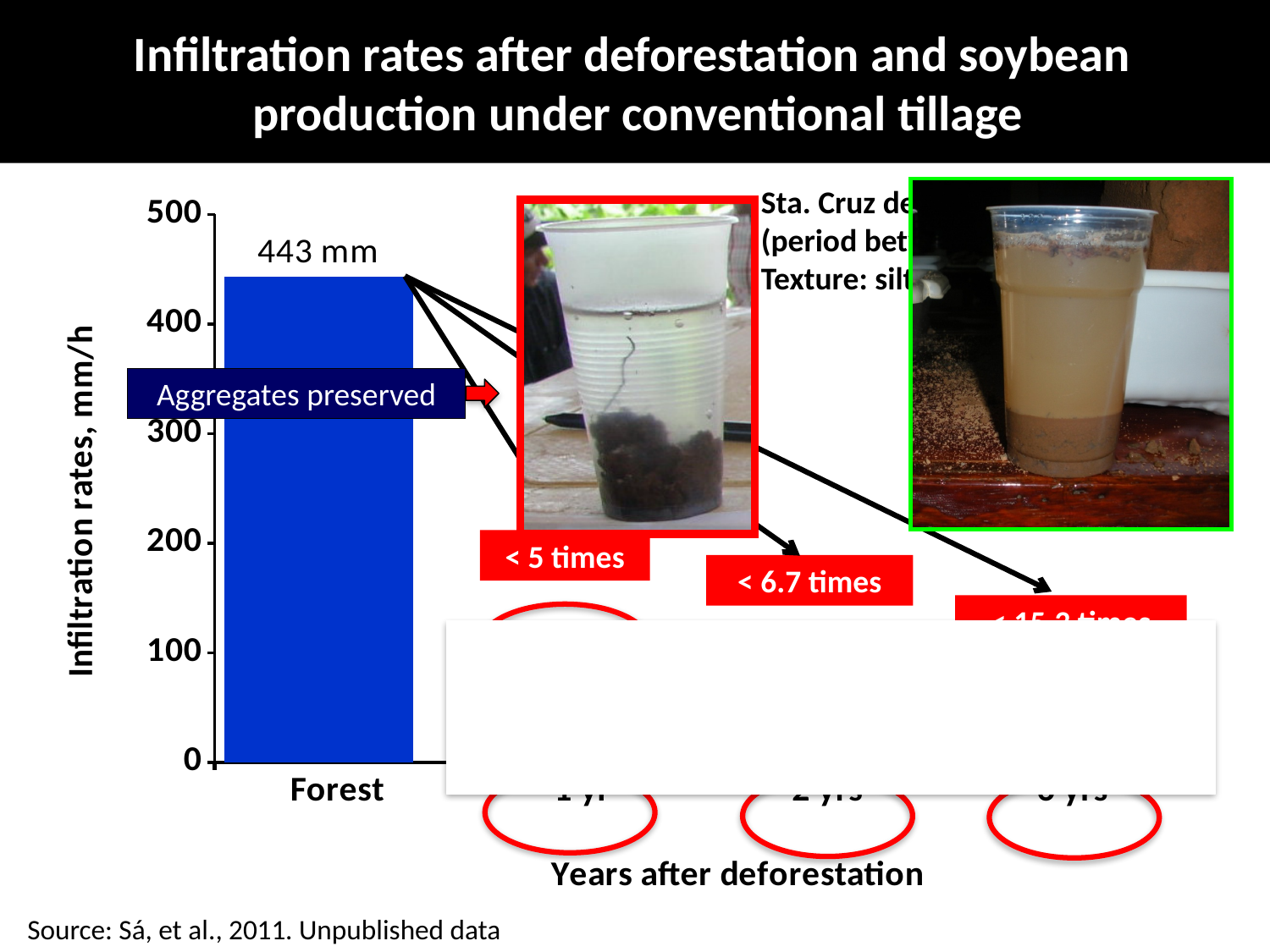
What is the label of the horizontal axis of the chart? Years after deforestation What kind of chart is shown on the slide? bar chart What is the label of the vertical axis of the chart? Infiltration rates, mm/h Is the value for Forest greater or less than 400? greater What is the infiltration rate shown for the Forest category? 443 mm Is the value for Forest greater or less than 500? less What is the highest tick value shown on the vertical axis? 500